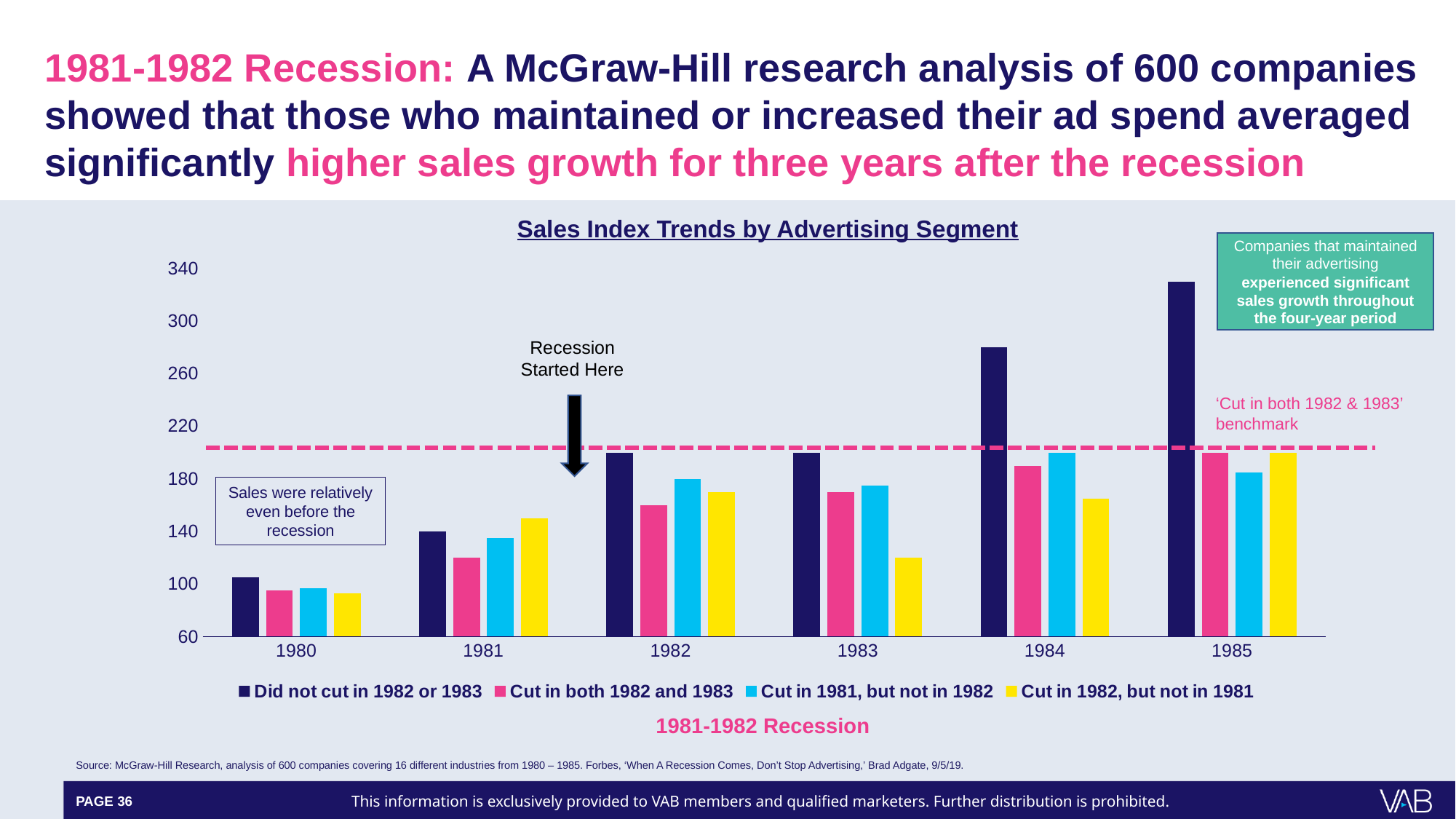
In 1984, which is larger: 'Did not cut in 1982 or 1983' or 'Cut in both 1982 and 1983'? Did not cut in 1982 or 1983 What is the title of the chart? Sales Index Trends by Advertising Segment In 1981, which is larger: 'Cut in 1982, but not in 1981' or 'Cut in both 1982 and 1983'? Cut in 1982, but not in 1981 Is the value for 'Did not cut in 1982 or 1983' in 1980 greater or less than 140? less How many series does the legend of the chart list? 4 How many years are shown along the x axis of the chart? 6 Is the value for 'Did not cut in 1982 or 1983' in 1985 greater or less than 300? greater In which year is the value for 'Did not cut in 1982 or 1983' lowest? 1980 In which year is the value for 'Did not cut in 1982 or 1983' highest? 1985 Does the value for 'Did not cut in 1982 or 1983' rise or fall from 1980 to 1985? Rise Is the value for 'Cut in 1982, but not in 1981' in 1983 greater or less than 140? less What kind of chart is shown on the slide? Bar chart